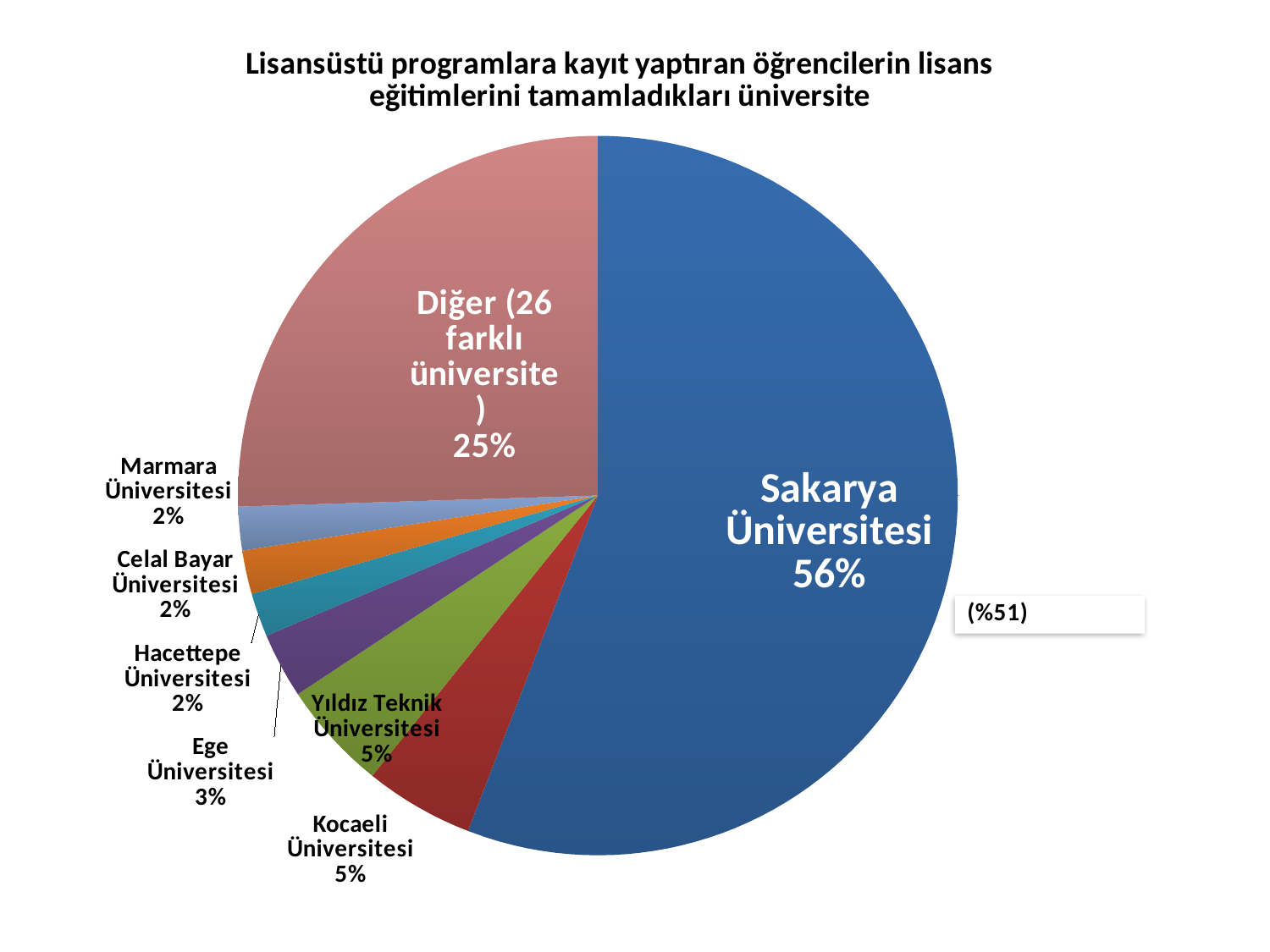
Which category has the largest slice of the pie? Sakarya Üniversitesi What kind of chart is shown on the slide? Pie chart What share of the pie does Sakarya Üniversitesi hold? 56% What is the title of the chart? Lisansüstü programlara kayıt yaptıran öğrencilerin lisans eğitimlerini tamamladıkları üniversite How many slices does the pie chart have? 8 What is the value shown for Marmara Üniversitesi? 2% What percentage is shown for the 'Diğer (26 farklı üniversite)' slice? 25% Which is larger, the share for Ege Üniversitesi or the share for Hacettepe Üniversitesi? Ege Üniversitesi What is the value shown for Ege Üniversitesi? 3% What is the combined share of Kocaeli Üniversitesi and Yıldız Teknik Üniversitesi? 10% What is the value shown for Kocaeli Üniversitesi? 5% What is the difference between the Sakarya Üniversitesi share and the 'Diğer (26 farklı üniversite)' share? 31%